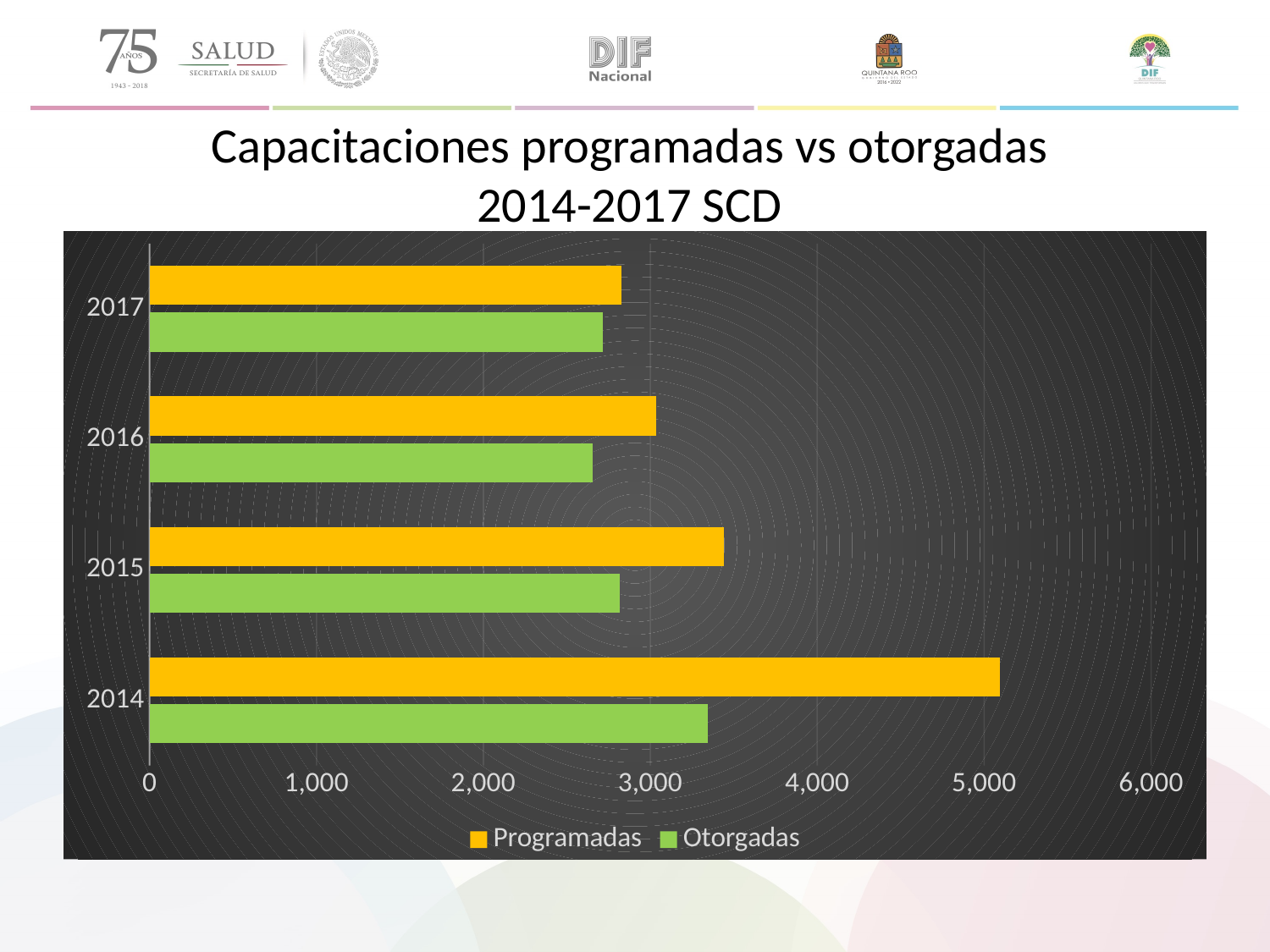
How many series does the legend list? 2 Which year has the larger Programadas value: 2015 or 2016? 2015 How many years are shown on the vertical axis of the chart? 4 Which colour represents the Otorgadas series in the chart? green What kind of chart is shown on the slide? bar chart In 2014, which is larger: Programadas or Otorgadas? Programadas Is the Otorgadas value for 2016 greater or less than 3,000? less Is the Programadas value for 2014 greater or less than 4,000? greater In which year is the Otorgadas value highest? 2014 In which year is the Programadas value highest? 2014 Is the Otorgadas value for 2014 greater or less than 3,000? greater